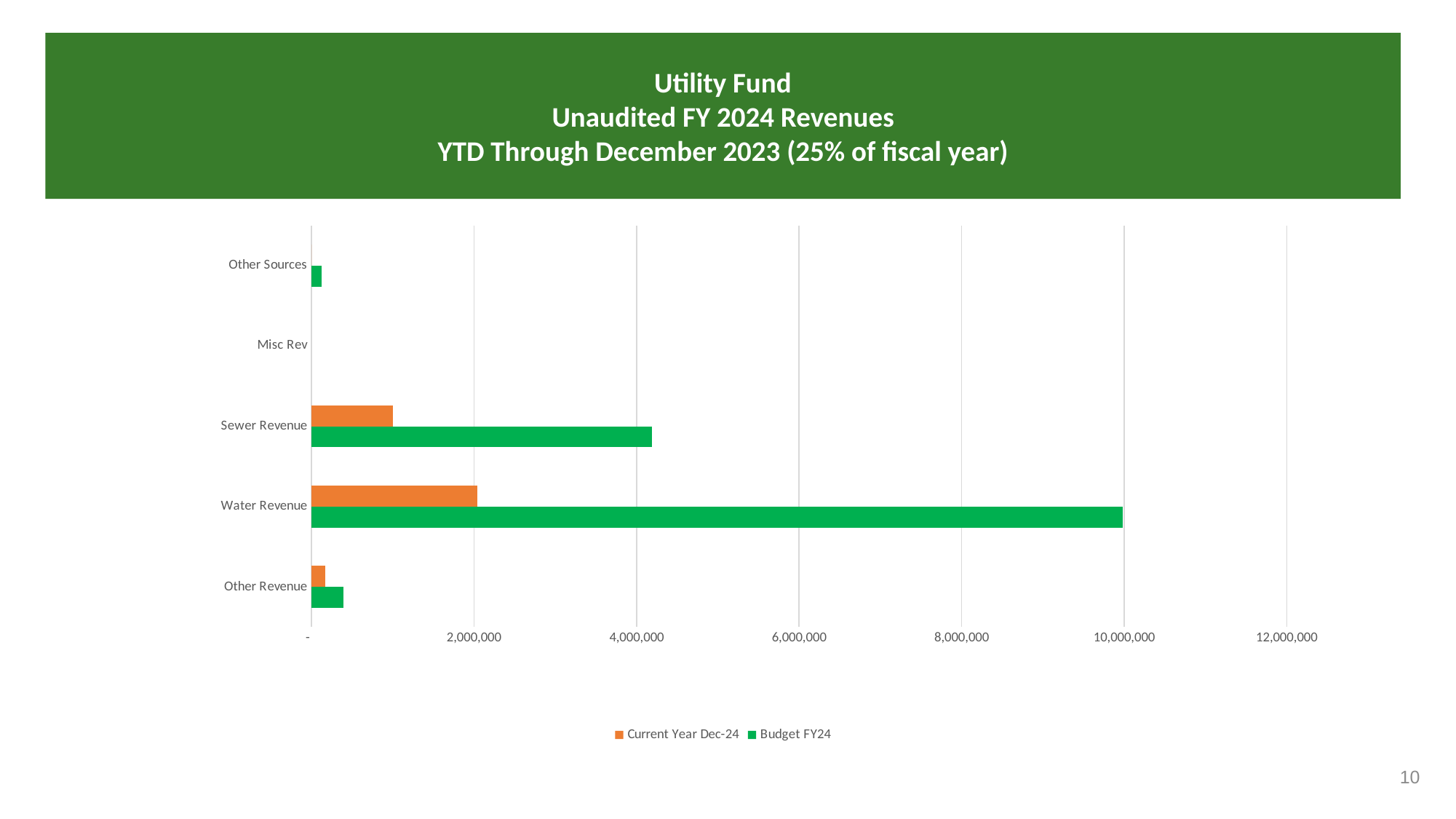
Which category has the highest Current Year Dec-24 value? Water Revenue How many series does the legend list? 2 How many categories are shown on the vertical axis of the chart? 5 Is the Budget FY24 value for Water Revenue greater or less than 8,000,000? greater Which is larger, the Budget FY24 value for Sewer Revenue or the Budget FY24 value for Other Revenue? Sewer Revenue Is the Current Year Dec-24 value for Water Revenue greater or less than 4,000,000? less What kind of chart is shown on the slide? bar chart Which series is shown in orange in the legend? Current Year Dec-24 Which category has the highest Budget FY24 value? Water Revenue Which is larger for Water Revenue, the Current Year Dec-24 value or the Budget FY24 value? Budget FY24 Is the Current Year Dec-24 value for Sewer Revenue greater or less than 2,000,000? less